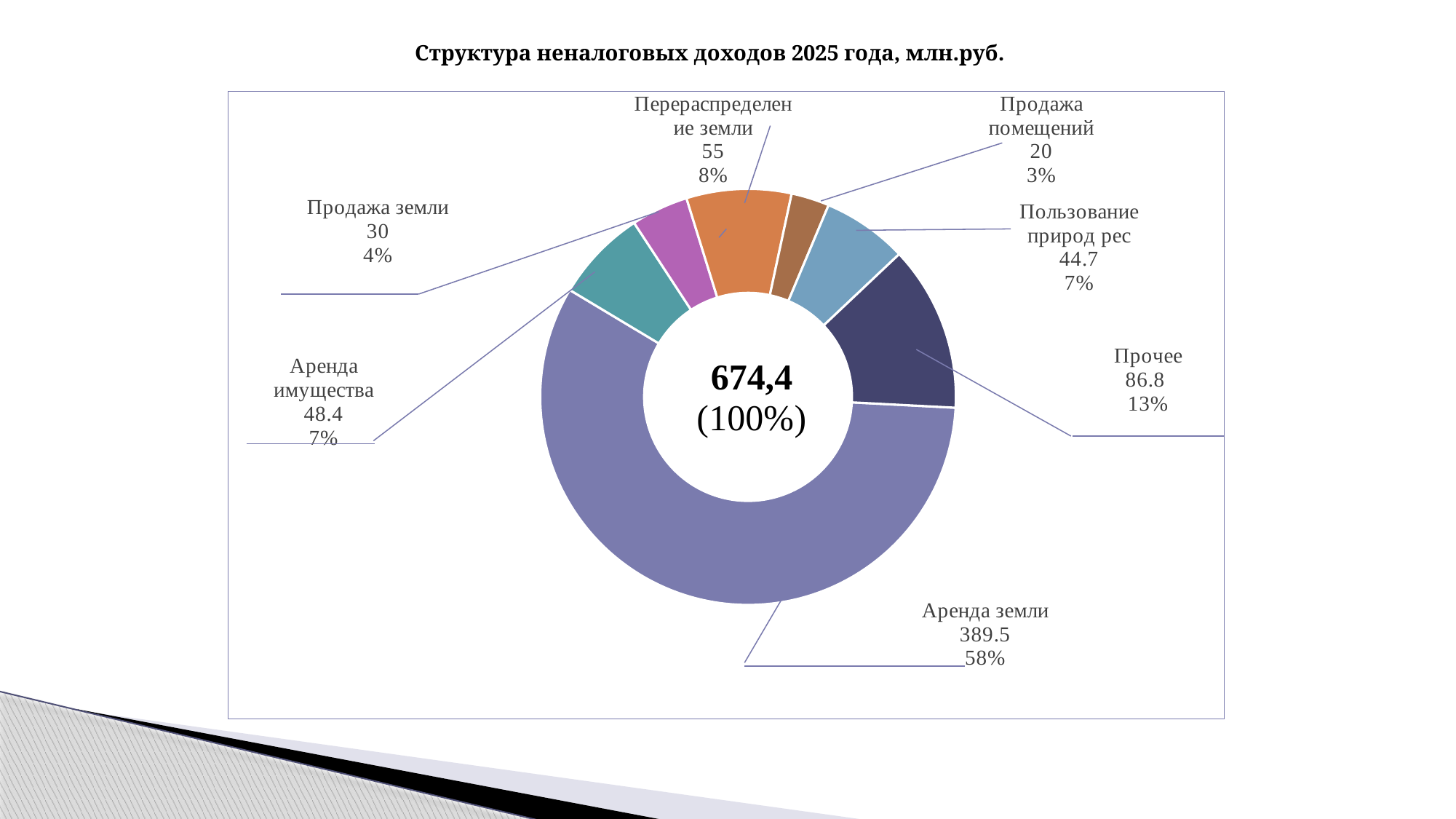
What is the difference between Прочее and Перераспределение земли? 31.8 What is the value for Прочее? 86.8 How many categories does the chart show? 7 What is the value for Пользование природ рес? 44.7 What type of chart is shown on the slide? Doughnut (pie) chart What is the value for Аренда земли? 389.5 Which category has the highest value? Аренда земли Which is larger, Аренда имущества or Пользование природ рес? Аренда имущества What is the value for Продажа помещений? 20 Which category has the lowest value? Продажа помещений What share of the total does Аренда земли represent? 58% What share of the total does Перераспределение земли represent? 8%